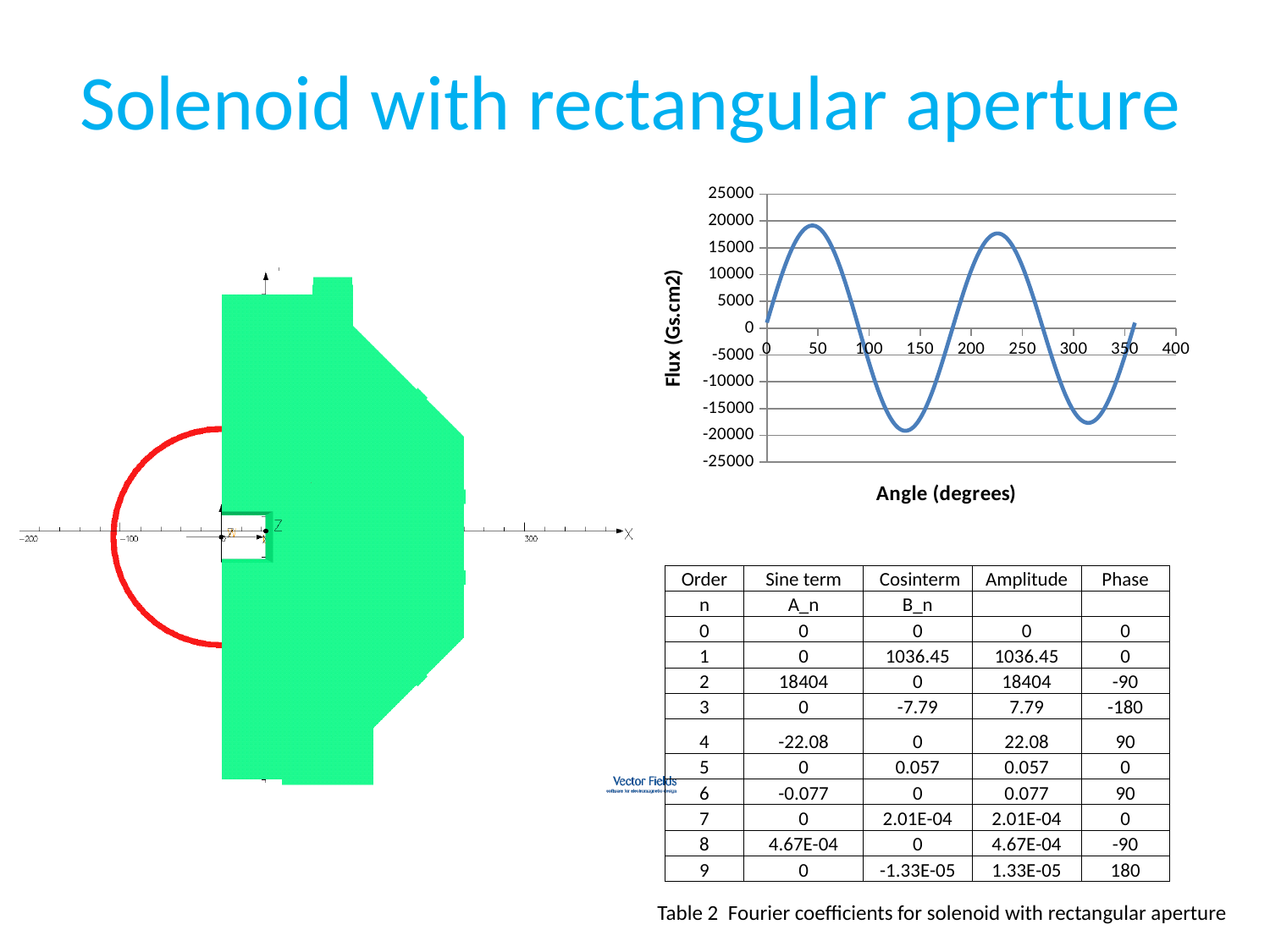
What is the highest value shown on the vertical axis of the chart? 25000 Is the flux value at an angle of 50 degrees greater or less than 15000? greater Is the flux value at an angle of 300 degrees greater or less than -10000? less Is the flux at 50 degrees larger or smaller than the flux at 150 degrees? larger What is the label of the vertical axis of the chart? Flux (Gs.cm2) Does the flux rise or fall as the angle increases from 50 to 150 degrees? fall Does the flux rise or fall as the angle increases from 0 to 50 degrees? rise Is the flux value at an angle of 0 degrees greater or less than 5000? less What kind of chart is shown on the slide? line chart What is the label of the horizontal axis of the chart? Angle (degrees)